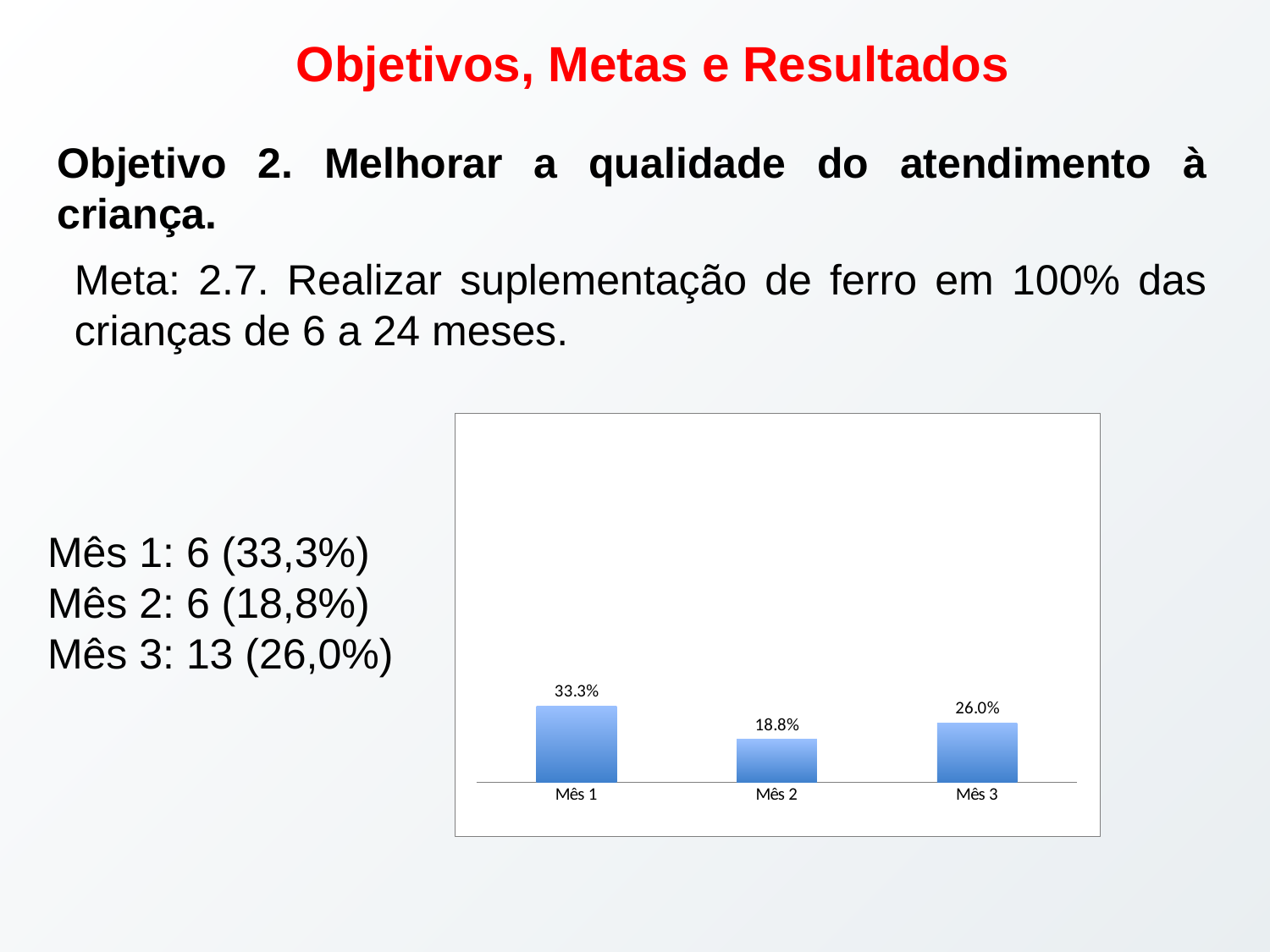
Does the value rise or fall from Mês 1 to Mês 2? Fall What is the difference between the values for Mês 1 and Mês 2? 14.5% Which month has the lowest value in the chart? Mês 2 What is the difference between the values for Mês 3 and Mês 2? 7.2% What is the value shown for Mês 1? 33.3% What colour are the bars in the chart? Blue Which month has the highest value in the chart? Mês 1 Which is larger, the value for Mês 1 or the value for Mês 3? Mês 1 What is the value shown for Mês 3? 26.0% How many categories are plotted in the chart? 3 What is the value shown for Mês 2? 18.8% What kind of chart is shown on the slide? Bar chart